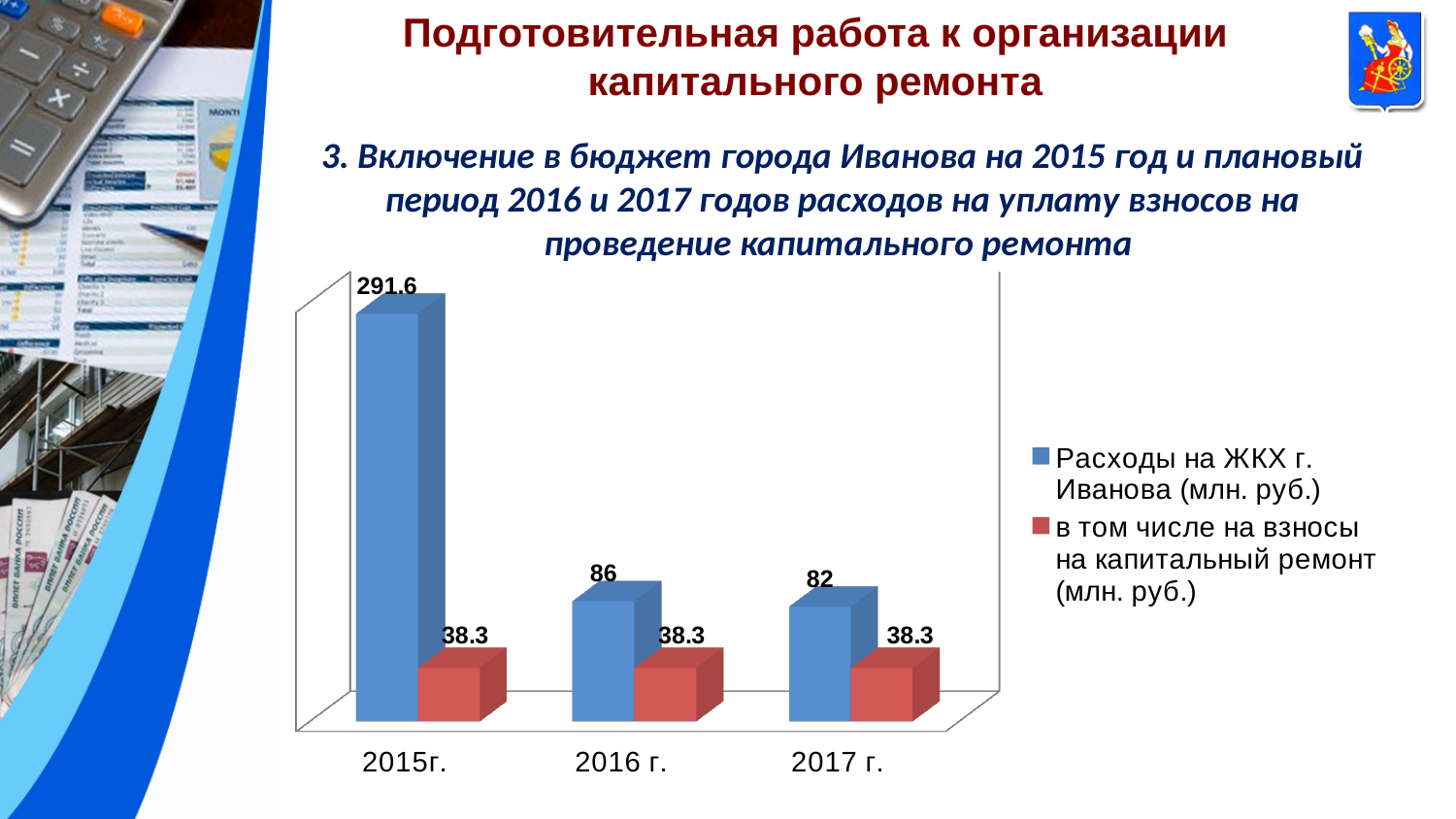
How many years are shown on the x axis of the chart? 3 What is the value of 'в том числе на взносы на капитальный ремонт (млн. руб.)' for 2017 г.? 38.3 What is the value of 'Расходы на ЖКХ г. Иванова (млн. руб.)' for 2015г.? 291.6 Which is larger: 'Расходы на ЖКХ г. Иванова (млн. руб.)' in 2016 г. or in 2017 г.? 2016 г. What is the difference between 'Расходы на ЖКХ г. Иванова (млн. руб.)' and 'в том числе на взносы на капитальный ремонт (млн. руб.)' in 2017 г.? 43.7 What is the difference between 'Расходы на ЖКХ г. Иванова (млн. руб.)' in 2015г. and 2016 г.? 205.6 In which year is 'Расходы на ЖКХ г. Иванова (млн. руб.)' lowest? 2017 г. What is the value of 'Расходы на ЖКХ г. Иванова (млн. руб.)' for 2017 г.? 82 What kind of chart is shown on the slide? Bar chart In which year is 'Расходы на ЖКХ г. Иванова (млн. руб.)' highest? 2015г. What is the value of 'Расходы на ЖКХ г. Иванова (млн. руб.)' for 2016 г.? 86 How many series does the chart legend list? 2